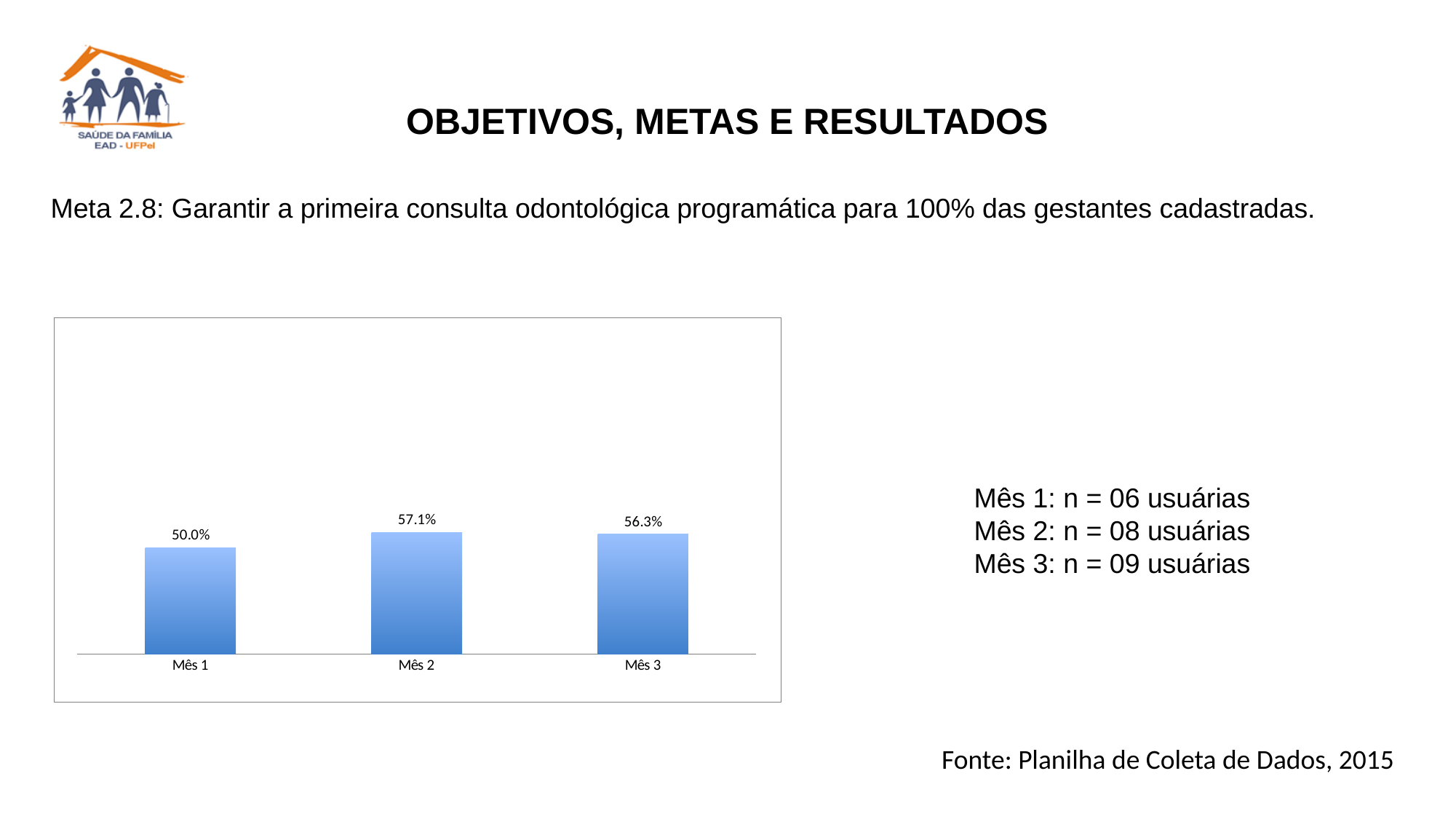
What kind of chart is shown on the slide? Bar chart What is the value for Mês 1? 50.0% How many months are shown on the chart? 3 Does the value rise or fall from Mês 1 to Mês 2? Rise Which is larger, the value for Mês 1 or the value for Mês 3? Mês 3 What is the difference between the values for Mês 2 and Mês 1? 7.1% What is the value for Mês 2? 57.1% What is the value for Mês 3? 56.3% What is the difference between the values for Mês 3 and Mês 1? 6.3% What colour are the bars in the chart? Blue Which month has the lowest value? Mês 1 Which month has the highest value? Mês 2